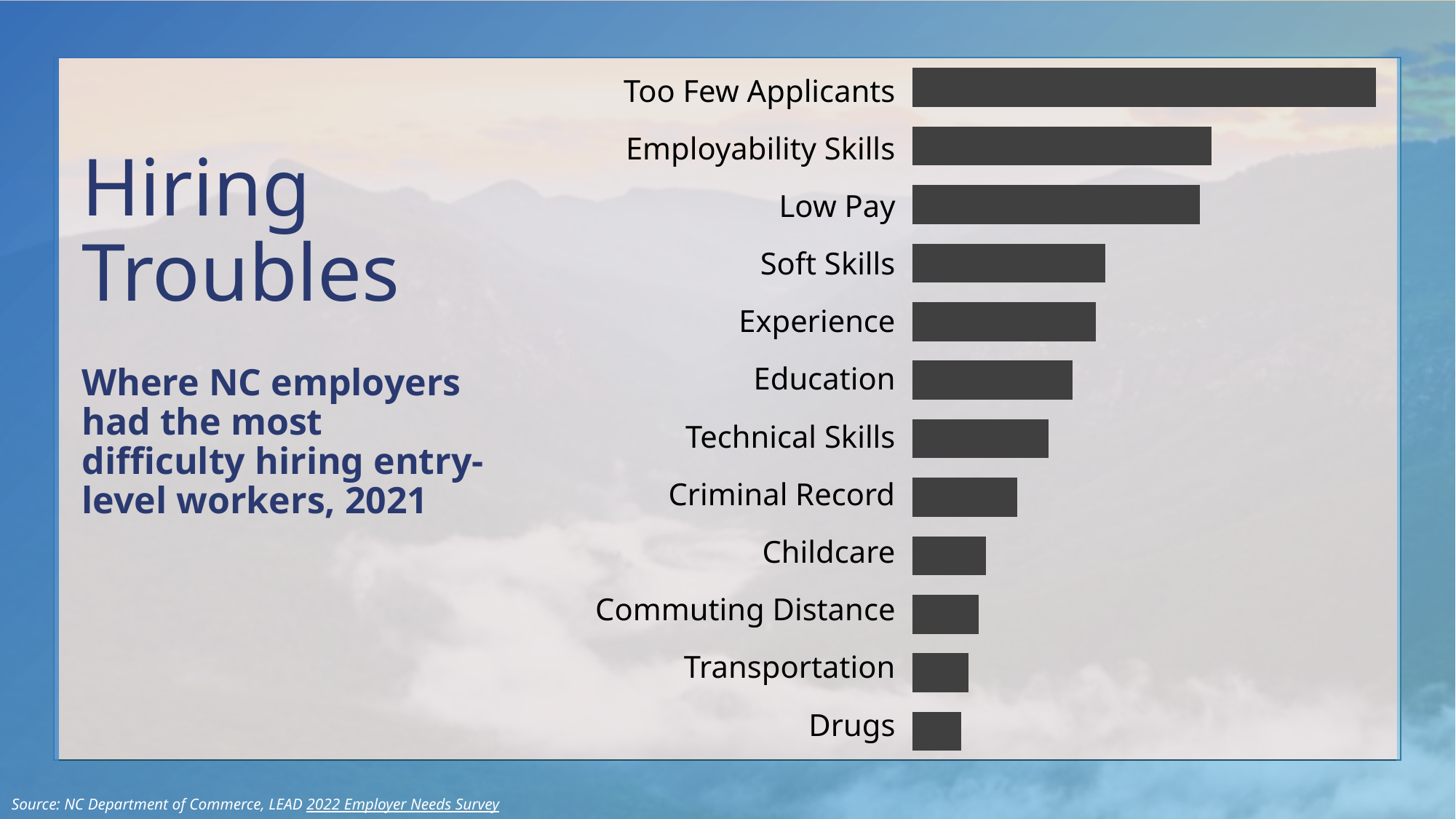
Which category has the shortest bar in the chart? Drugs Which has the longer bar, Too Few Applicants or Employability Skills? Too Few Applicants Which has the longer bar, Experience or Commuting Distance? Experience What kind of chart is shown on the slide? Bar chart Which has the longer bar, Technical Skills or Transportation? Technical Skills Which category has the longest bar in the chart? Too Few Applicants How many categories are shown in the bar chart? 12 Which category is listed at the top of the bar chart? Too Few Applicants What is the title of the slide containing the bar chart? Hiring Troubles